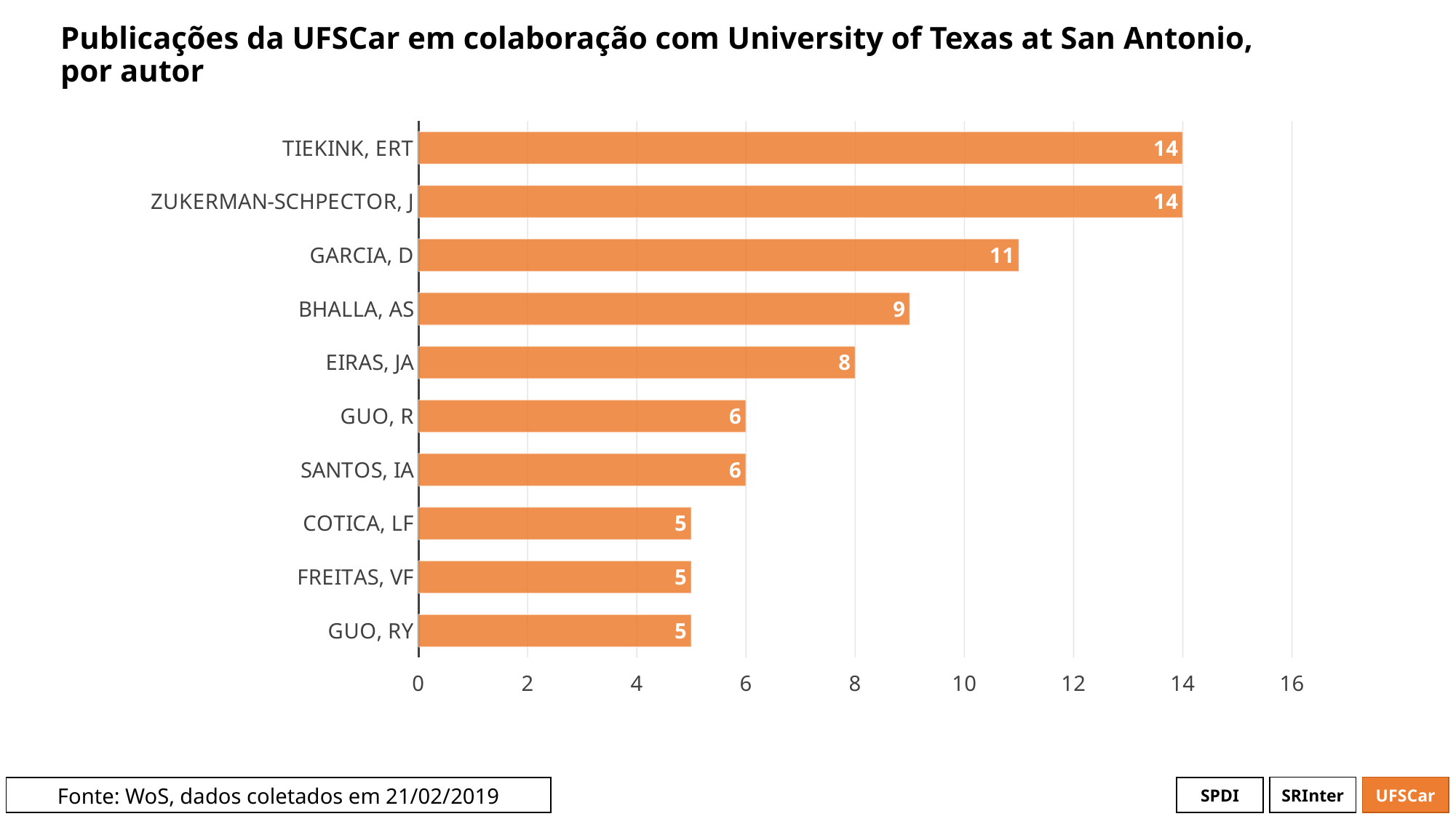
What is the value for COTICA, LF? 5 What is the difference between the values for TIEKINK, ERT and GUO, R? 8 What is the highest value shown on the chart? 14 How many publications are shown for GARCIA, D? 11 What is the difference between the values for GARCIA, D and BHALLA, AS? 2 What kind of chart is shown on the slide? Bar chart What is the source of the data cited on the slide? WoS, dados coletados em 21/02/2019 Which has a larger value, EIRAS, JA or SANTOS, IA? EIRAS, JA How many authors are shown on the chart? 10 What is the value for EIRAS, JA? 8 Which has a larger value, GARCIA, D or BHALLA, AS? GARCIA, D What is the value for BHALLA, AS? 9